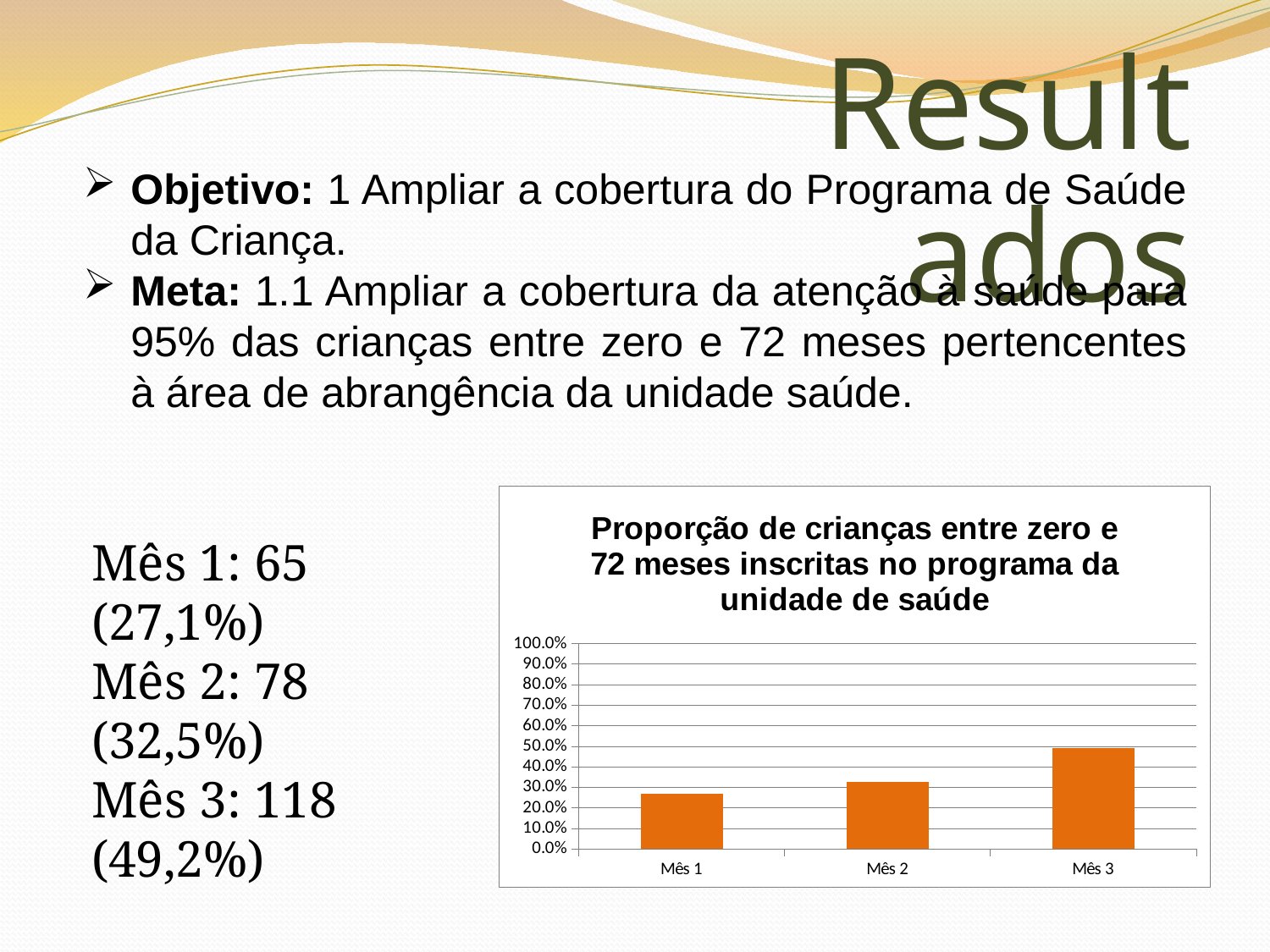
Is the value for Mês 3 greater or less than 40.0%? greater Which month has the lowest bar in the chart? Mês 1 Is the value for Mês 3 greater or less than 50.0%? less Which month has the highest bar in the chart? Mês 3 Is the value for Mês 2 greater or less than 30.0%? greater What is the title of the chart? Proporção de crianças entre zero e 72 meses inscritas no programa da unidade de saúde How many categories (months) are plotted in the chart? 3 Which is larger, the value for Mês 2 or the value for Mês 3? Mês 3 What kind of chart is shown on the slide? bar chart Do the values rise or fall from Mês 1 to Mês 3? rise What is the maximum value shown on the chart's vertical axis? 100.0%